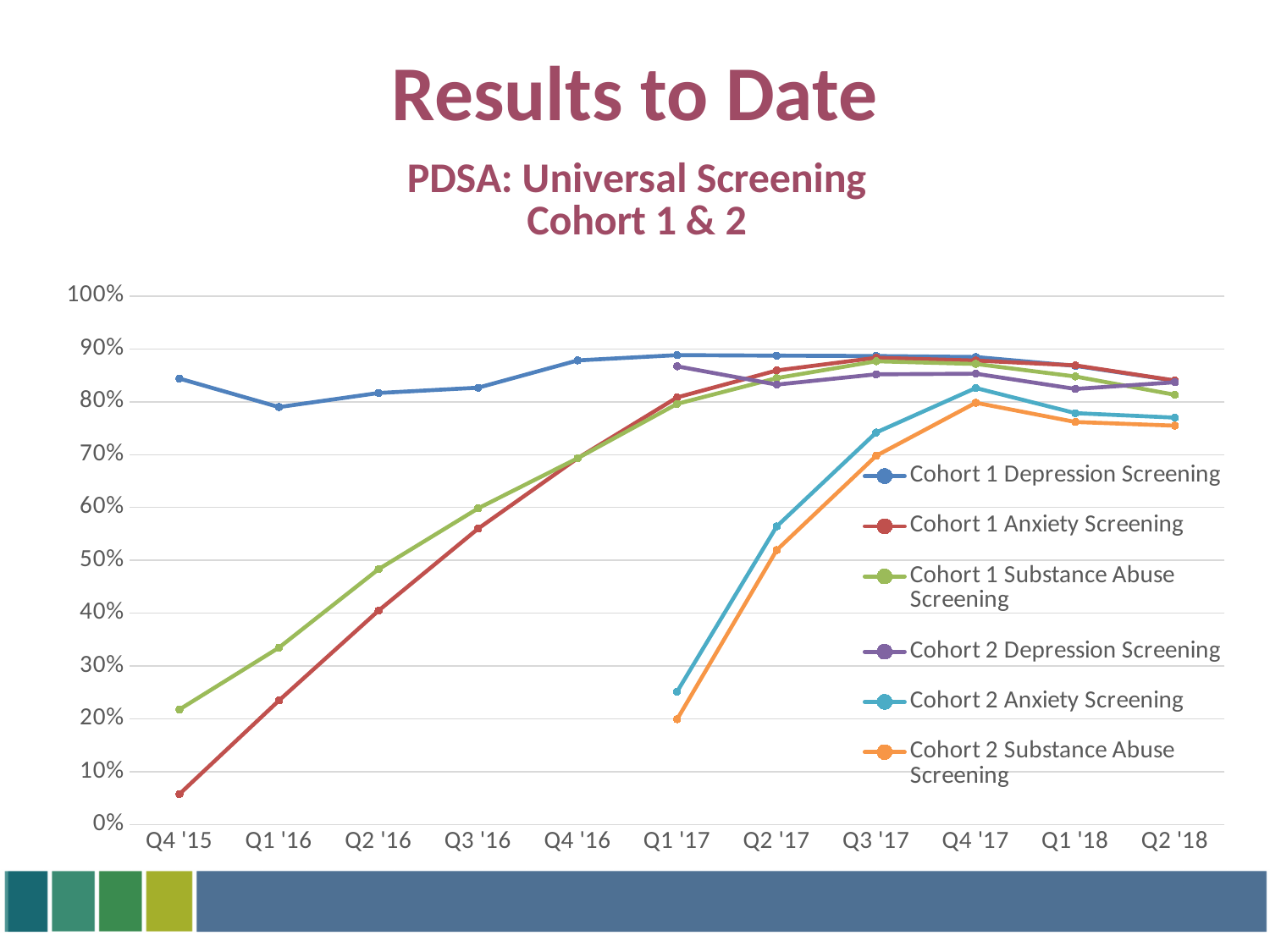
Which series has the highest value at Q2 '16? Cohort 1 Depression Screening Which series has the lowest value at Q1 '17? Cohort 2 Substance Abuse Screening Is the value for Cohort 2 Depression Screening at Q1 '17 greater or less than 80%? greater At Q1 '16, which is larger: Cohort 1 Depression Screening or Cohort 1 Anxiety Screening? Cohort 1 Depression Screening How many quarters are shown along the x axis? 11 Is the value for Cohort 1 Anxiety Screening at Q4 '15 greater or less than 10%? less Is the value for Cohort 2 Anxiety Screening at Q1 '17 greater or less than 30%? less How many series does the legend list? 6 Does the Cohort 1 Anxiety Screening line rise or fall from Q4 '15 to Q3 '17? rise What kind of chart is shown on the slide? line chart What is the title of the chart? PDSA: Universal Screening Cohort 1 & 2